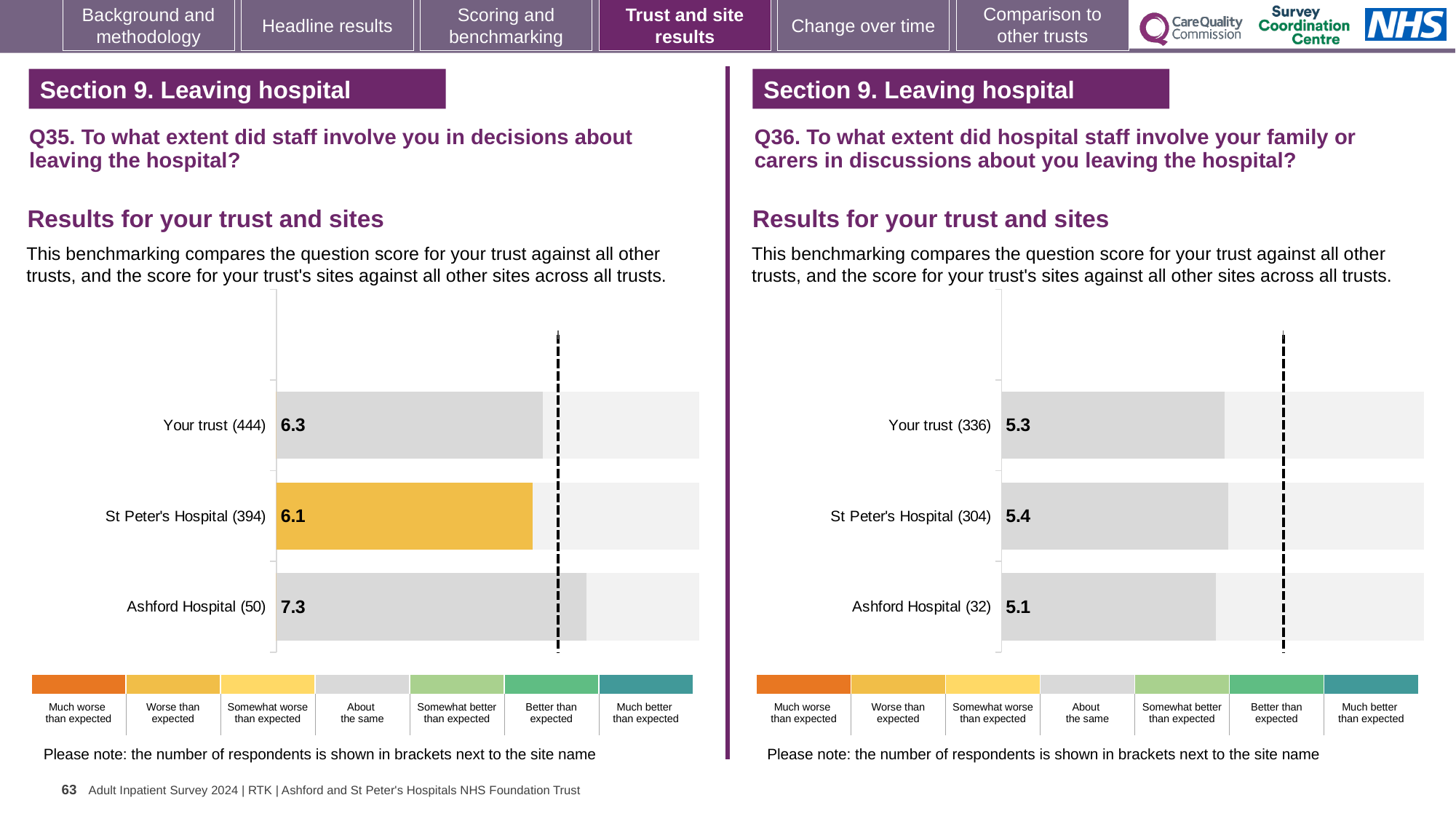
In the Q36 chart on the right, what is the score for Ashford Hospital? 5.1 In the Q35 chart on the left, which bar is coloured orange/yellow rather than grey? St Peter's Hospital In the Q35 chart on the left, which row has the highest score? Ashford Hospital In the Q36 chart on the right, what is the difference between the St Peter's Hospital score and the Your trust score? 0.1 In the Q35 chart on the left, what is the difference between the Ashford Hospital score and the St Peter's Hospital score? 1.2 How many rows (bars) are shown in the Q36 chart on the right? 3 In the Q35 chart on the left, what is the score for Ashford Hospital? 7.3 In the Q35 chart on the left, what is the score for Your trust? 6.3 What type of chart is used in the Q35 chart on the left? Bar chart In the Q36 chart on the right, which row has the lowest score? Ashford Hospital In the Q35 chart on the left, which has the larger score, Your trust or St Peter's Hospital? Your trust In the Q36 chart on the right, what is the score for St Peter's Hospital? 5.4